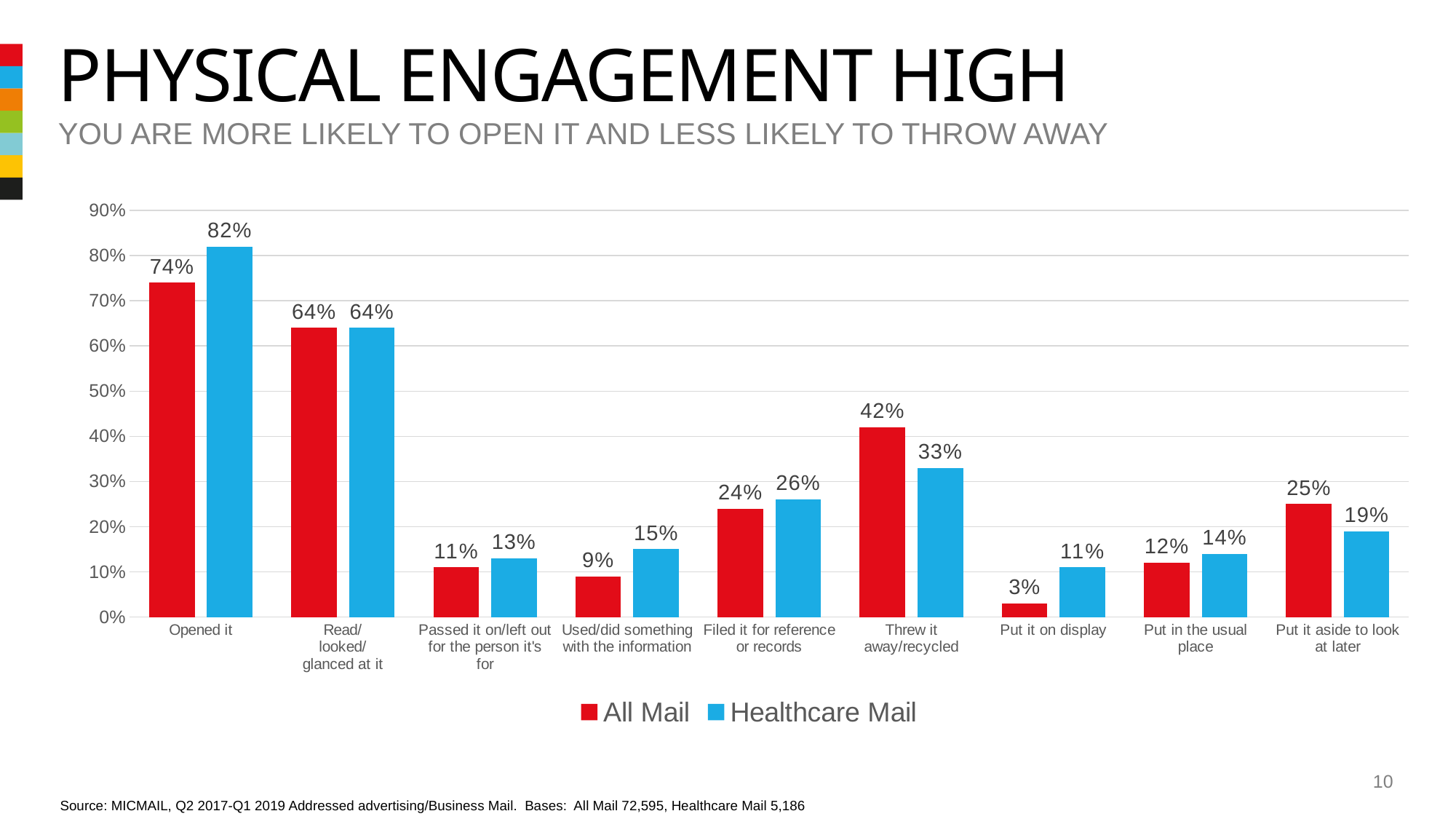
Which category has the highest Healthcare Mail value? Opened it For "Put it aside to look at later", which is larger: All Mail or Healthcare Mail? All Mail Which colour represents Healthcare Mail in the chart? Blue Which category has the lowest All Mail value? Put it on display What is the Healthcare Mail value for "Opened it"? 82% How many categories are shown on the x axis? 9 What is the difference between the Healthcare Mail and All Mail values for "Opened it"? 8% How many series does the legend list? 2 What is the All Mail value for "Put it on display"? 3% What is the difference between the All Mail and Healthcare Mail values for "Threw it away/recycled"? 9% What is the All Mail value for "Threw it away/recycled"? 42% What kind of chart is shown on the slide? Bar chart